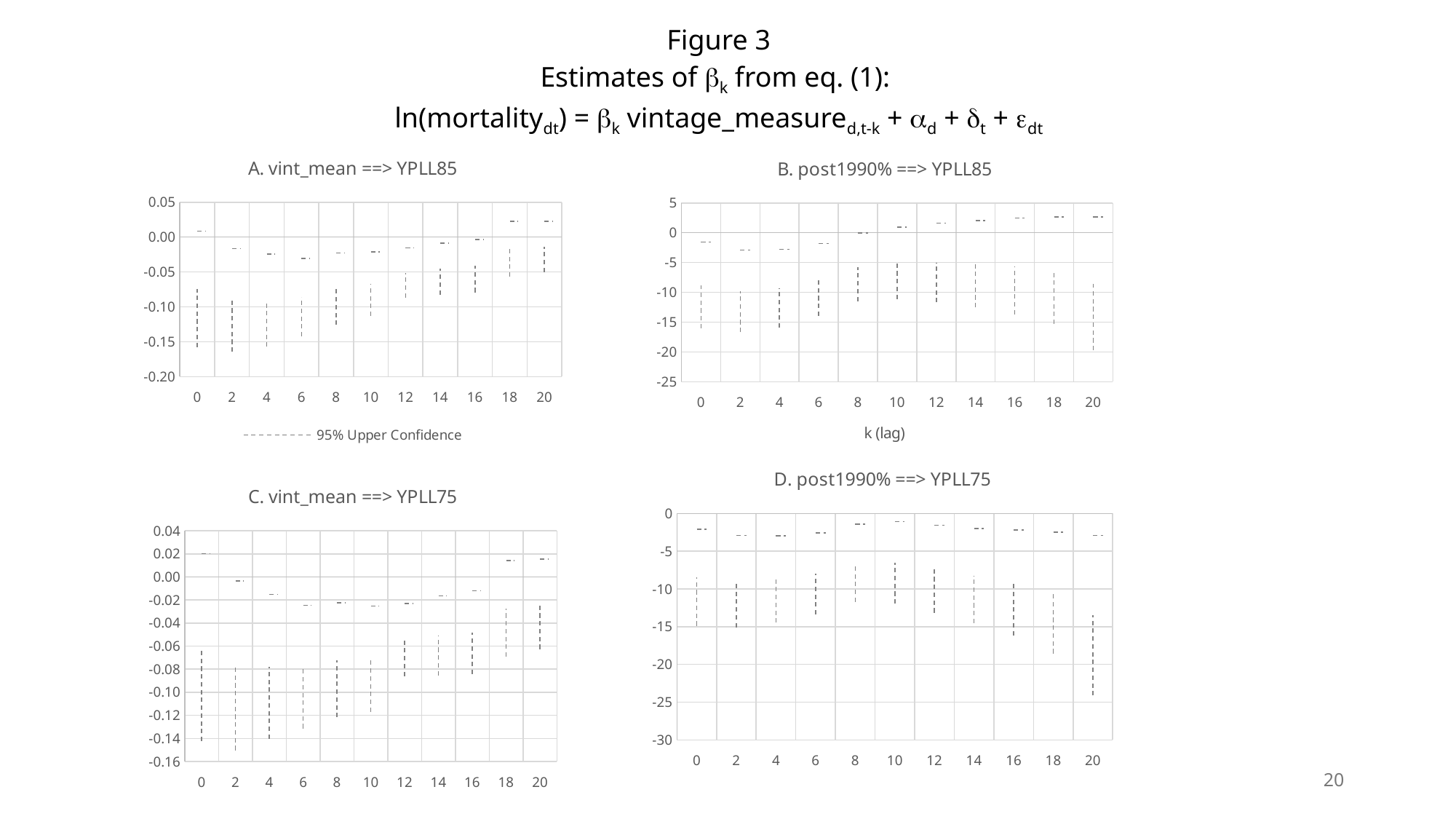
In chart D (post1990% ==> YPLL75), which lag has the lower bottom end of its confidence interval, k = 0 or k = 20? k = 20 In chart B (post1990% ==> YPLL85), what is the x-axis label? k (lag) In chart C (vint_mean ==> YPLL75), is the upper confidence value at k = 0 greater or less than 0.00? greater In chart A (vint_mean ==> YPLL85), how many lag values are marked on the x axis? 11 In chart A (vint_mean ==> YPLL85), is the 95% upper confidence value at k = 0 greater or less than 0.00? greater In chart B (post1990% ==> YPLL85), is the upper confidence value at k = 20 greater or less than 0? greater In chart A (vint_mean ==> YPLL85), does the 95% upper confidence value rise or fall as k increases from 2 to 20? rise In chart A (vint_mean ==> YPLL85), which lag has the higher bottom end of its confidence interval, k = 0 or k = 20? k = 20 What is the title of the top-left chart? A. vint_mean ==> YPLL85